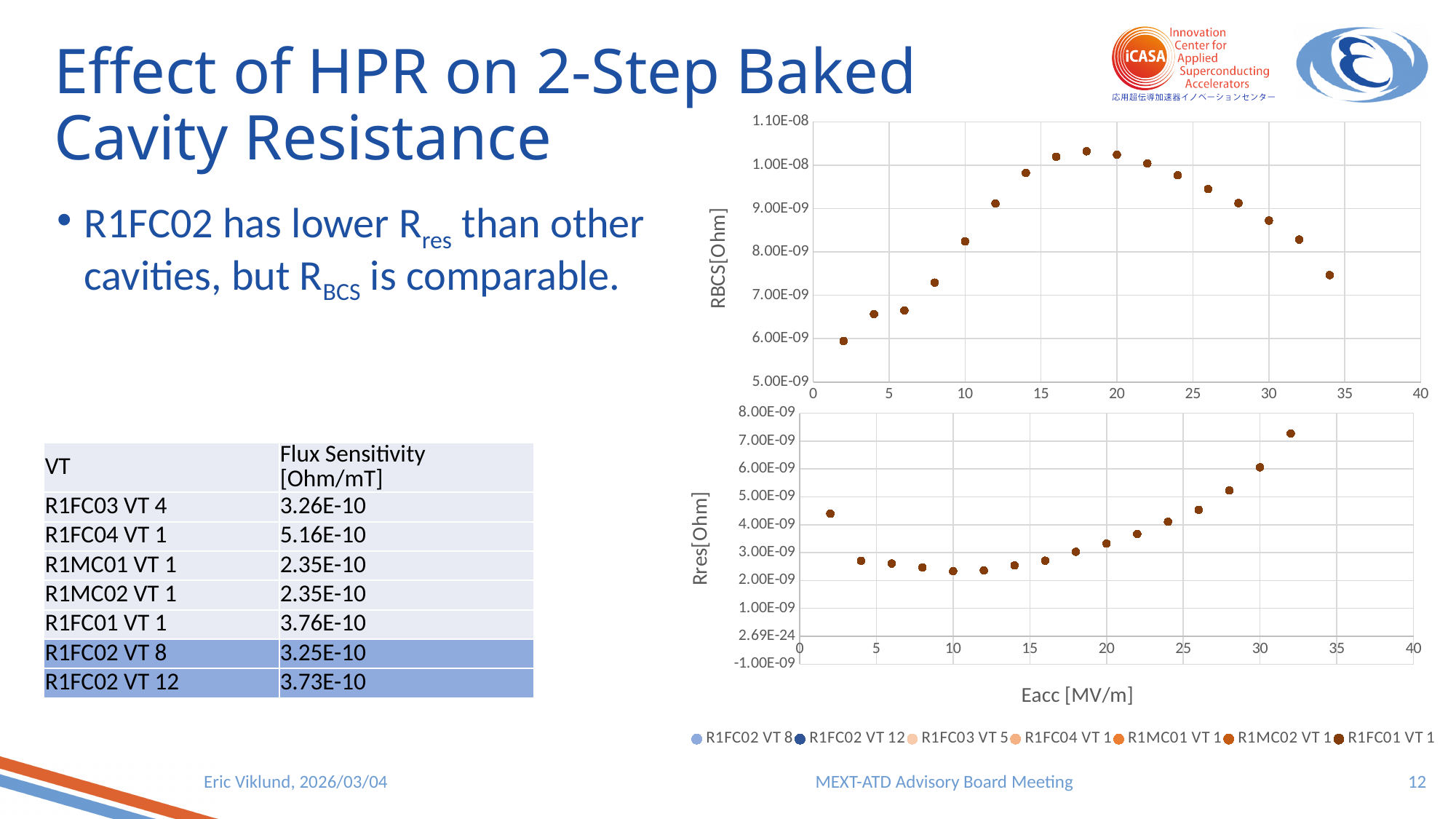
In the bottom chart (Rres[Ohm]), is the value at Eacc = 10 MV/m greater or less than 3.00E-09? less What is the label of the shared x axis of the two charts? Eacc [MV/m] In the bottom chart (Rres[Ohm]), is the value at Eacc = 32 MV/m greater or less than 7.00E-09? greater What kind of chart is the top chart (RBCS[Ohm] vs Eacc)? scatter chart In the top chart (RBCS[Ohm]), is the value at Eacc = 34 MV/m greater or less than 8.00E-09? less In the bottom chart (Rres[Ohm]), at which Eacc value is Rres highest? 32 MV/m What kind of chart is the bottom chart (Rres[Ohm] vs Eacc)? scatter chart In the top chart (RBCS[Ohm]), at which Eacc value is RBCS lowest? 2 MV/m In the bottom chart (Rres[Ohm]), do the values rise or fall as Eacc increases from 20 to 32 MV/m? rise How many series does the legend below the charts list? 7